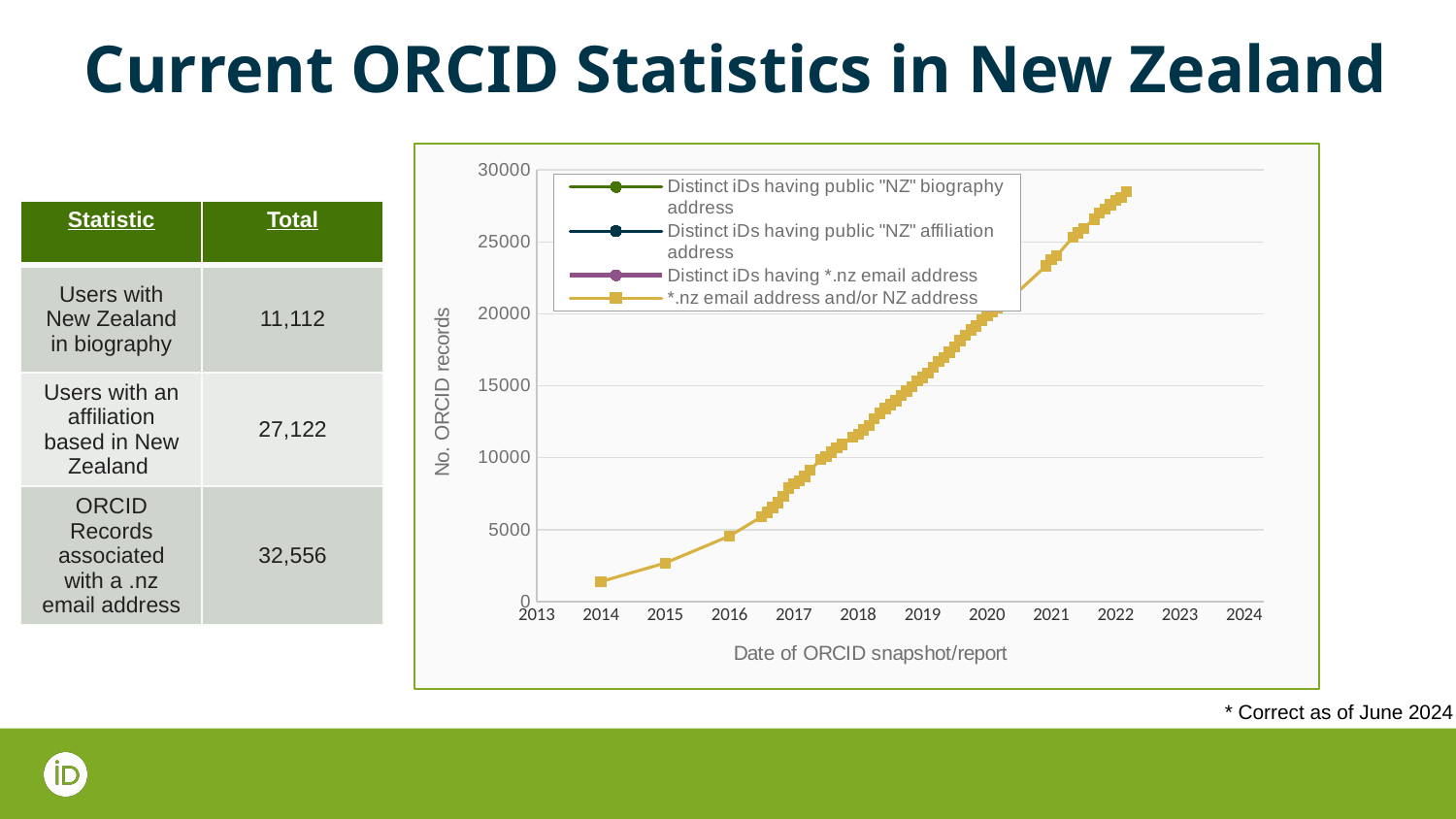
How many series does the chart's legend list? 4 Is the value plotted for 2022 greater or less than 25000? greater What is the title of the chart's vertical axis? No. ORCID records Is the value plotted for 2015 greater or less than 5000? less Which is larger, the value plotted for 2016 or the value plotted for 2021? 2021 Is the value plotted for 2017 greater or less than 10000? less What is the title of the chart's horizontal axis? Date of ORCID snapshot/report In which year does the plotted line reach its highest value? 2022 Do the plotted values rise or fall from 2014 to 2022? rise What kind of chart is shown on the slide? line chart